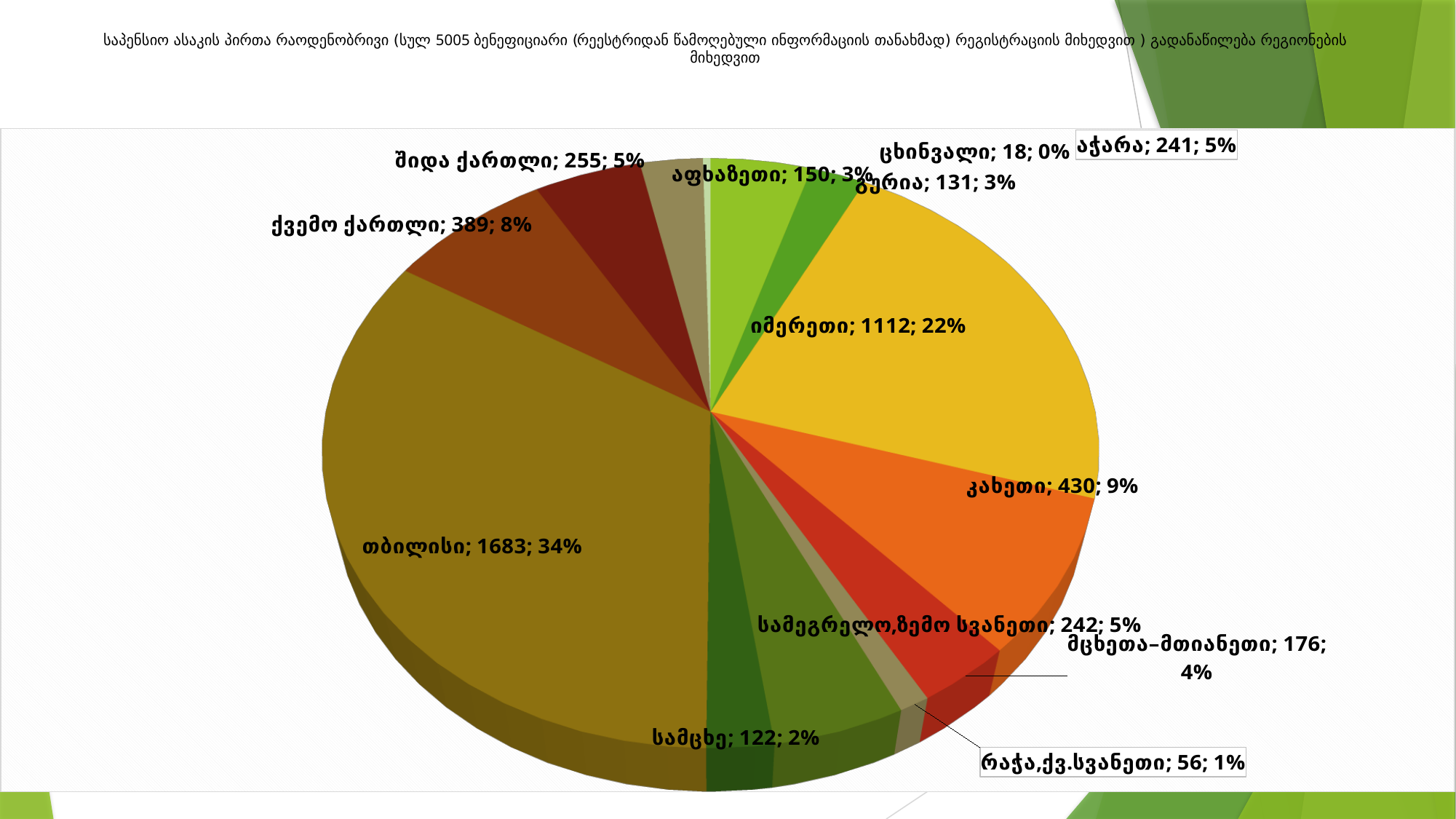
What share of the pie does ქვემო ქართლი represent? 8% What kind of chart is shown on the slide? pie chart What is the value for თბილისი? 1683 Which is larger, the value for აჭარა or the value for სამცხე? აჭარა Which region has the largest slice? თბილისი How many slices (regions) does the pie chart have? 13 What share of the pie does კახეთი represent? 9% What is the value for იმერეთი? 1112 Which region has the smallest slice? ცხინვალი What is the difference between the values for თბილისი and იმერეთი? 571 What is the difference between the values for კახეთი and ქვემო ქართლი? 41 What is the value for მცხეთა-მთიანეთი? 176